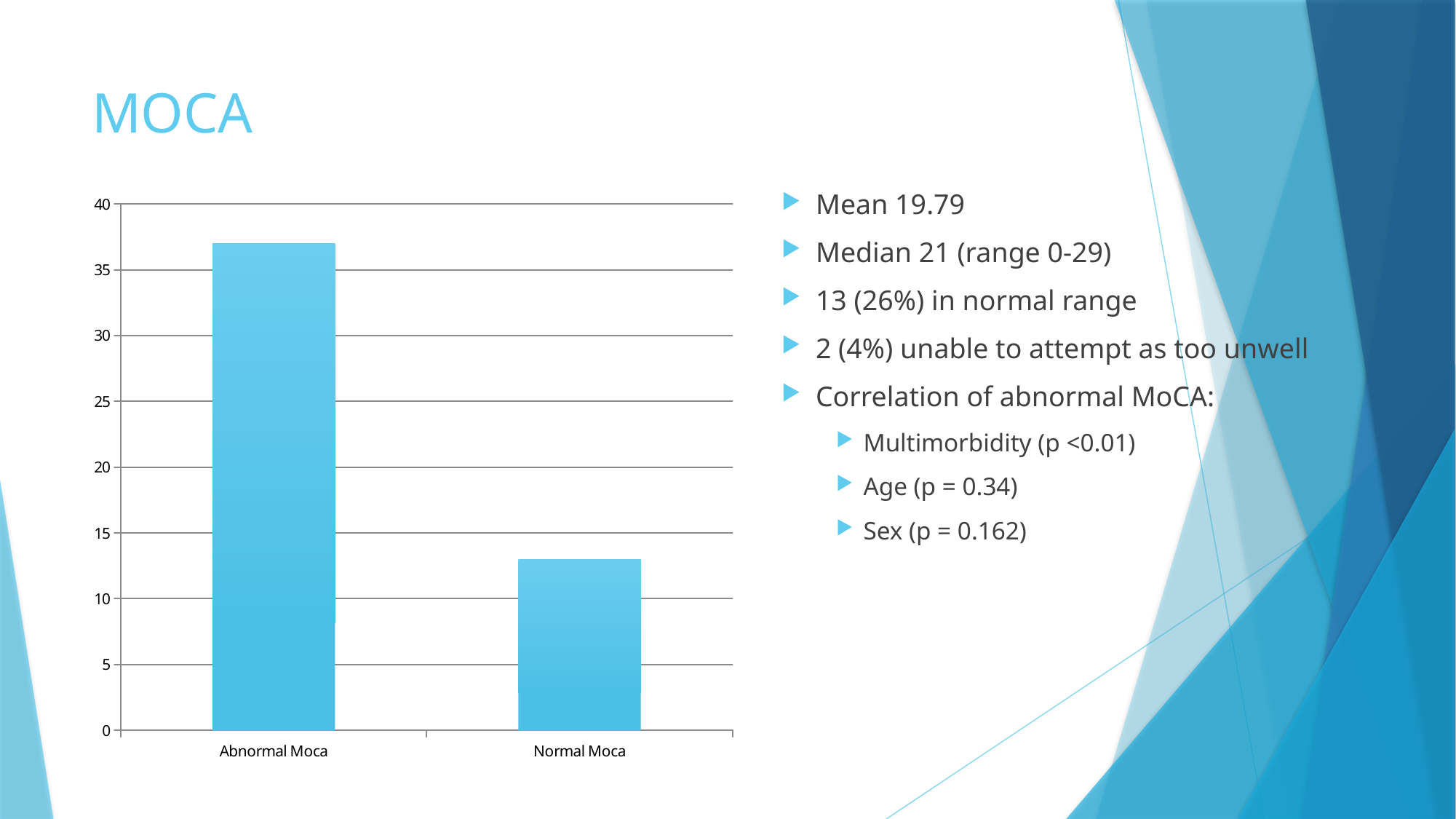
What is the title of the slide containing the chart? MOCA Is the value for Normal Moca greater or less than 10? greater What is the highest value shown on the vertical axis of the chart? 40 Which category has the lowest bar? Normal Moca Is the value for Normal Moca greater or less than 15? less How many categories are plotted on the chart? 2 Which category has the highest bar? Abnormal Moca Is the value for Abnormal Moca greater or less than 40? less What kind of chart is shown on the slide? bar chart Which is larger, the value for Abnormal Moca or the value for Normal Moca? Abnormal Moca